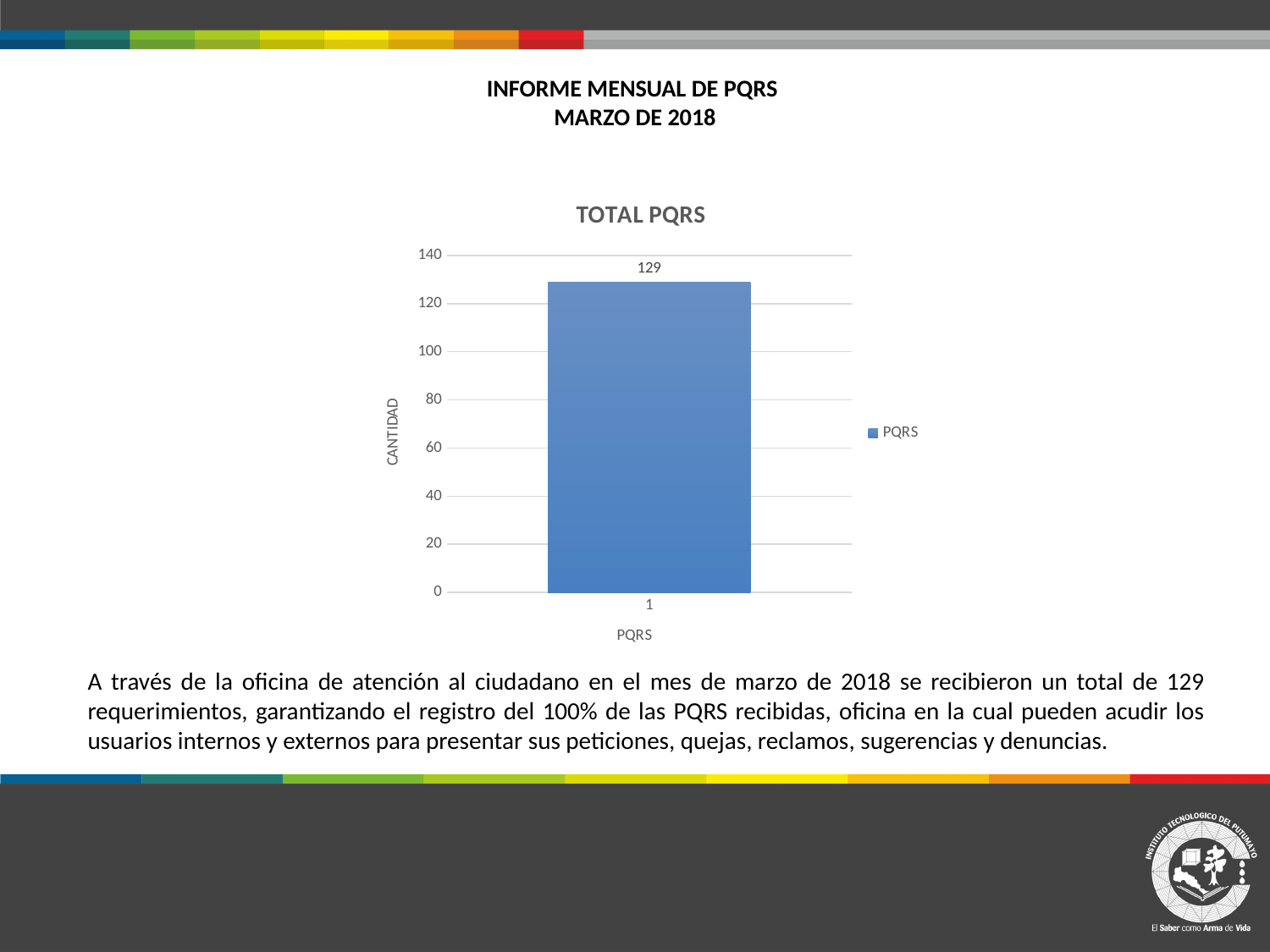
What kind of chart is TOTAL PQRS? bar chart What is the category label shown under the bar in the TOTAL PQRS chart? 1 What is the label on the vertical axis of the TOTAL PQRS chart? CANTIDAD Is the value of the PQRS bar greater or less than 140? less How many series does the legend of the TOTAL PQRS chart list? 1 What is the title of the chart on the slide? TOTAL PQRS How many bars are plotted in the TOTAL PQRS chart? 1 Is the value of the PQRS bar greater or less than 120? greater What is the value of the PQRS bar in the TOTAL PQRS chart? 129 What is the highest tick value shown on the vertical axis of the TOTAL PQRS chart? 140